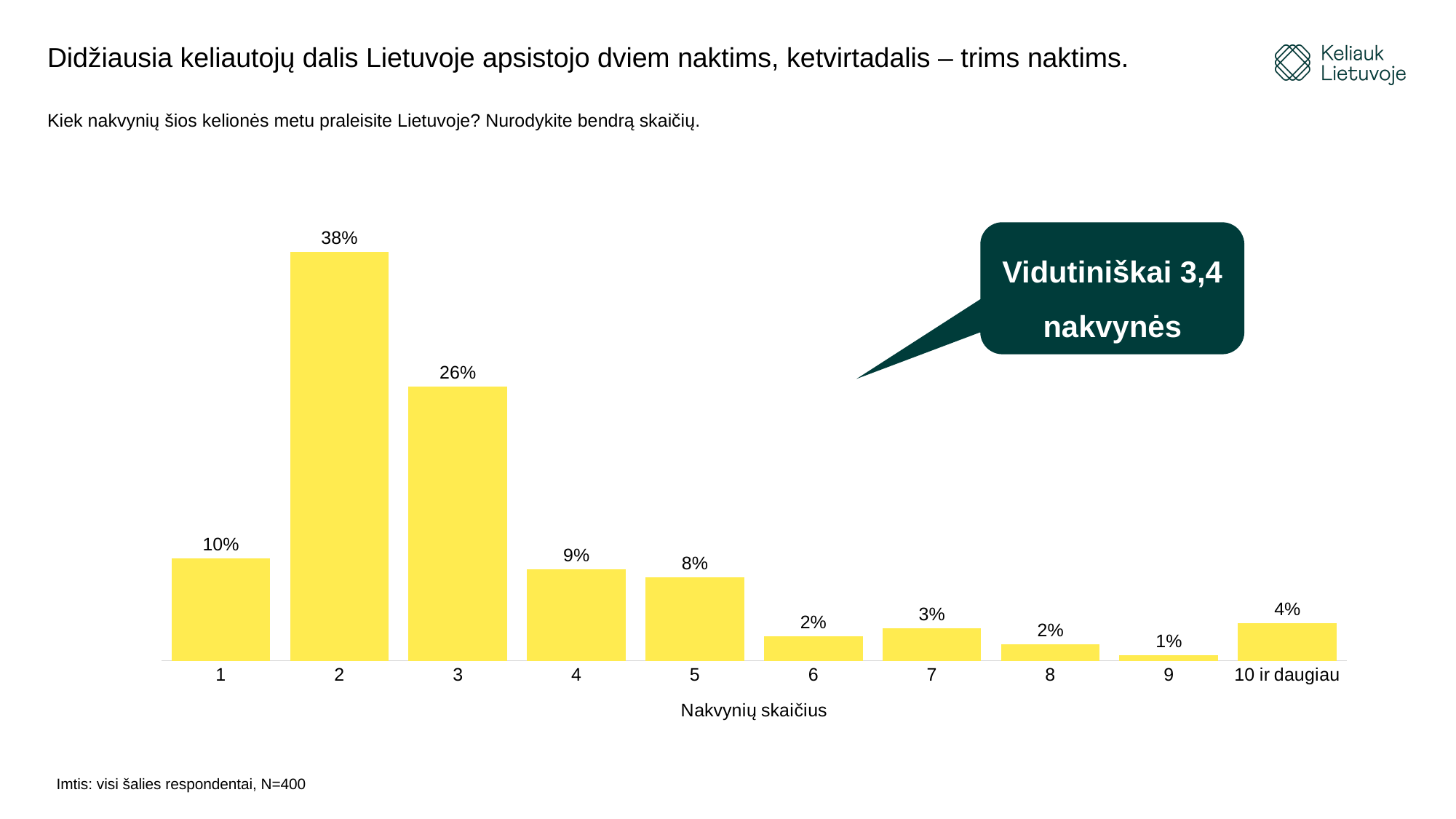
What kind of chart is shown on the slide? Bar chart How many categories are shown on the x axis? 10 What percentage is shown for the '10 ir daugiau' category? 4% What is the value shown for 3 nights? 26% Which number of nights has the lowest share of travellers? 9 What is the difference between the shares for 1 night and 4 nights? 1 percentage point What average number of nights is stated in the callout on the slide? 3,4 nakvynės Which is larger, the share for 4 nights or the share for 5 nights? 4 nights What percentage of travellers stayed 2 nights in Lithuania? 38% Which number of nights has the highest share of travellers? 2 Do the values generally rise or fall from 3 nights to 9 nights? Fall What is the difference between the shares for 2 nights and 3 nights? 12 percentage points